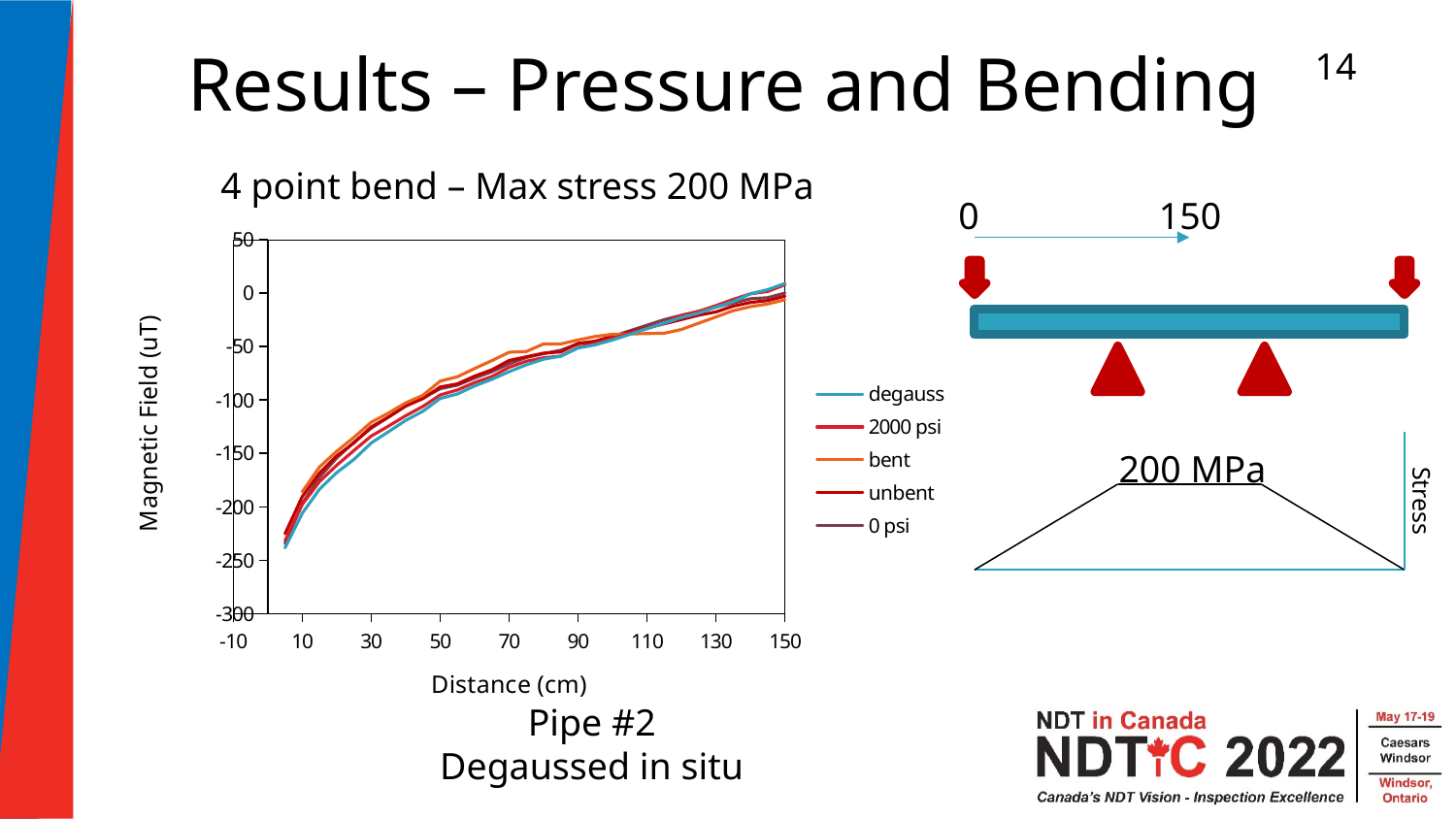
How many series does the chart's legend list? 5 Do the magnetic field values rise or fall as distance increases along the x axis? rise What is the title of the chart? 4 point bend – Max stress 200 MPa Is the magnetic field value for the 2000 psi series at a distance of 130 cm greater or less than -50? greater What kind of chart is shown on the slide? line chart Is the magnetic field value for the unbent series at a distance of 10 cm greater or less than -100? less Which series is listed first in the chart's legend? degauss What is the label of the chart's x axis? Distance (cm) Is the magnetic field value for the degauss series at a distance of 10 cm greater or less than -150? less